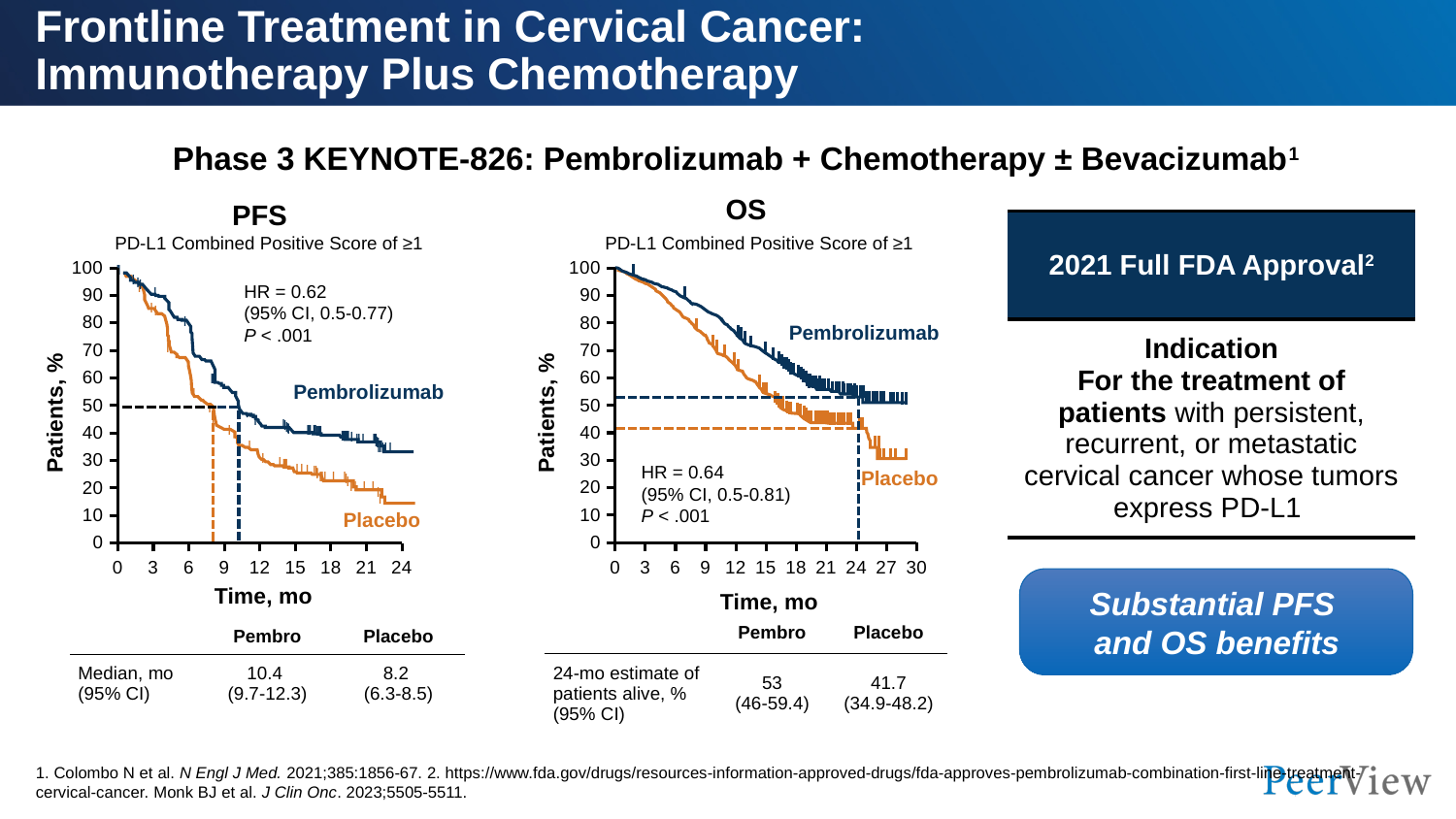
In the OS chart, what is the 24-month estimate of patients alive (%) for the Placebo arm? 41.7 In the OS chart, which arm has the higher 24-month estimate of patients alive, Pembro or Placebo? Pembro In the PFS chart, is the Placebo curve at 12 months greater or less than 50%? less In the PFS chart, do the curves rise or fall as time increases? fall In the PFS chart, what is the difference in median PFS (months) between the Pembro and Placebo arms? 2.2 In the OS chart, what is the highest value shown on the Time, mo axis? 30 In the OS chart, what is the 95% CI for the hazard ratio? 0.5-0.81 In the OS chart, what is the hazard ratio shown? HR = 0.64 In the PFS chart, what is the median PFS in months for the Pembro arm? 10.4 In the PFS chart, what is the median PFS in months for the Placebo arm? 8.2 In the OS chart, what is the 24-month estimate of patients alive (%) for the Pembro arm? 53 In the PFS chart, what is the hazard ratio shown? HR = 0.62